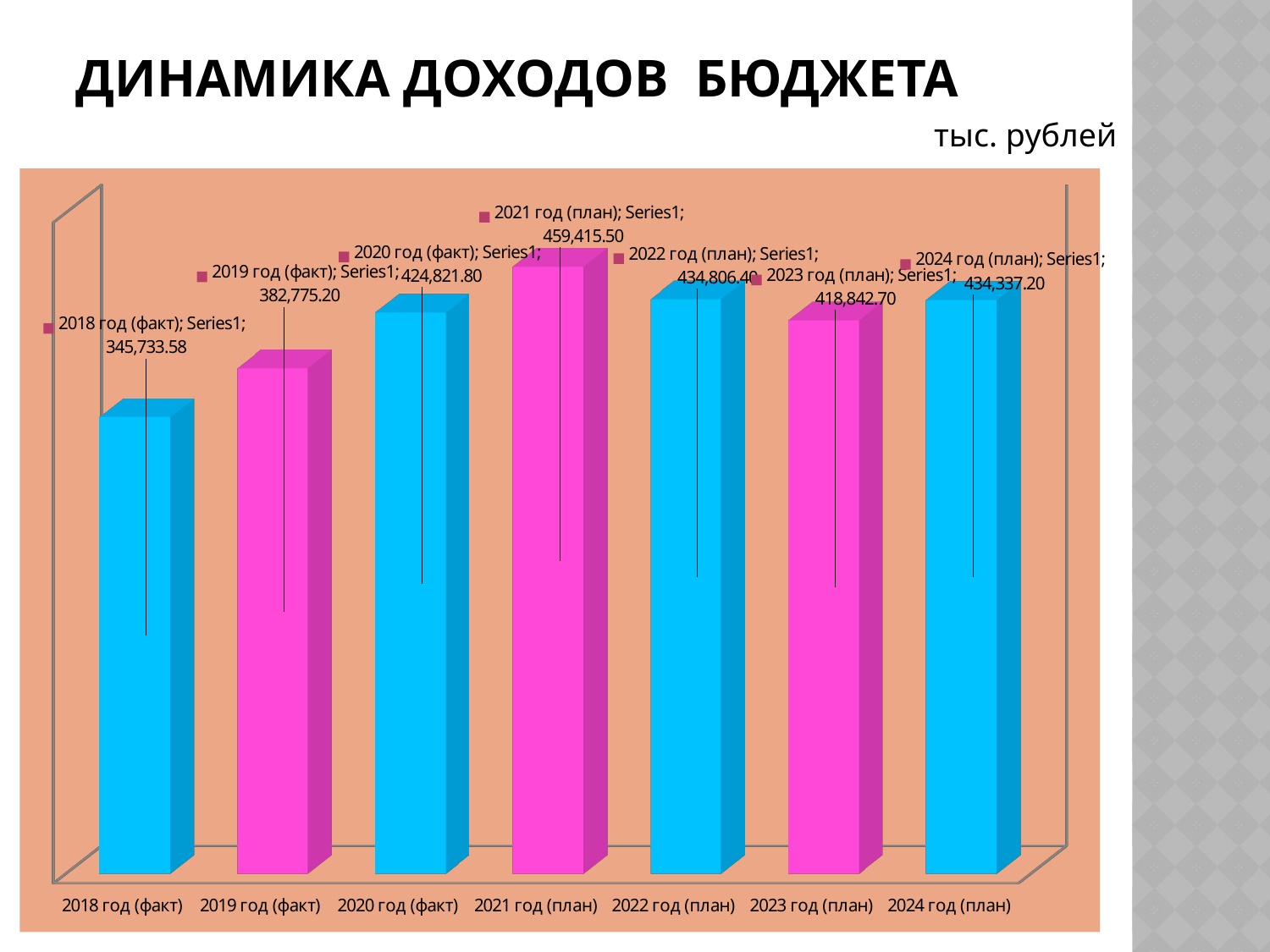
Which category has the lowest value? 2018 год (факт) How many categories are shown on the chart? 7 What is the value for 2023 год (план)? 418,842.70 What is the value for 2024 год (план)? 434,337.20 What kind of chart is shown on the slide? Bar chart What is the difference between the values for 2021 год (план) and 2018 год (факт)? 113,681.92 What is the title of the chart on the slide? ДИНАМИКА ДОХОДОВ БЮДЖЕТА Which category has the highest value? 2021 год (план) Which is larger, the value for 2022 год (план) or 2023 год (план)? 2022 год (план) What is the value for 2018 год (факт)? 345,733.58 What is the difference between the values for 2020 год (факт) and 2019 год (факт)? 42,046.60 What is the value for 2021 год (план)? 459,415.50